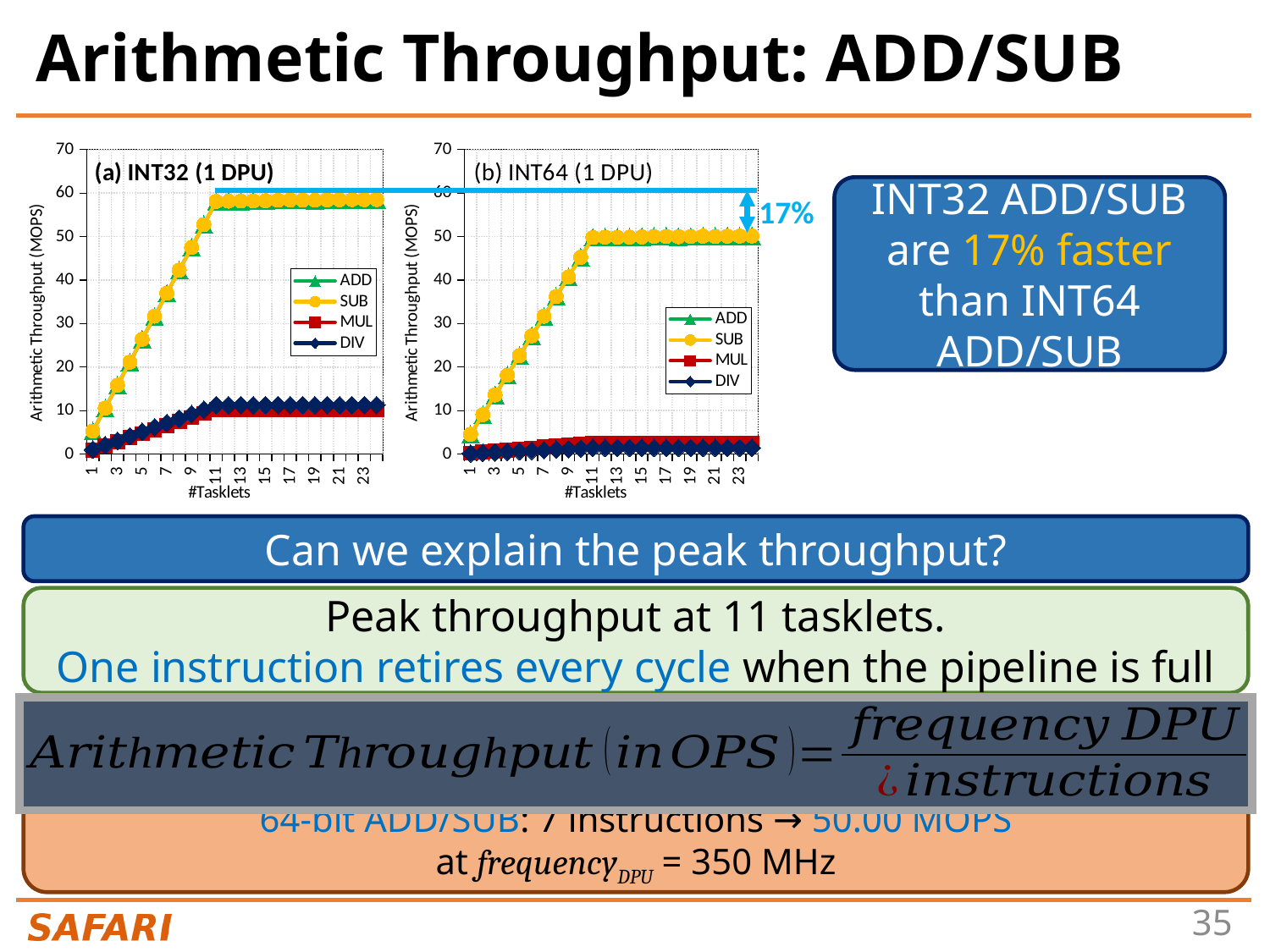
What kind of chart is the left chart, (a) INT32 (1 DPU)? line chart In the left chart, (a) INT32 (1 DPU), does the ADD throughput rise or fall as the number of tasklets increases from 1 to 11? rise In the right chart, (b) INT64 (1 DPU), is the SUB value at 23 tasklets greater or less than 60? less Which is larger at 23 tasklets: the ADD value in the left chart, (a) INT32 (1 DPU), or the ADD value in the right chart, (b) INT64 (1 DPU)? (a) INT32 (1 DPU) In the left chart, (a) INT32 (1 DPU), is the ADD value at 1 tasklet greater or less than 10? less What is the label of the x axis on the right chart, (b) INT64 (1 DPU)? #Tasklets What is the label of the y axis on the left chart, (a) INT32 (1 DPU)? Arithmetic Throughput (MOPS) In the right chart, (b) INT64 (1 DPU), is the MUL value at 23 tasklets greater or less than 10? less How many series does the legend of the right chart, (b) INT64 (1 DPU), list? 4 In the left chart, (a) INT32 (1 DPU), which is larger at 23 tasklets: SUB or DIV? SUB